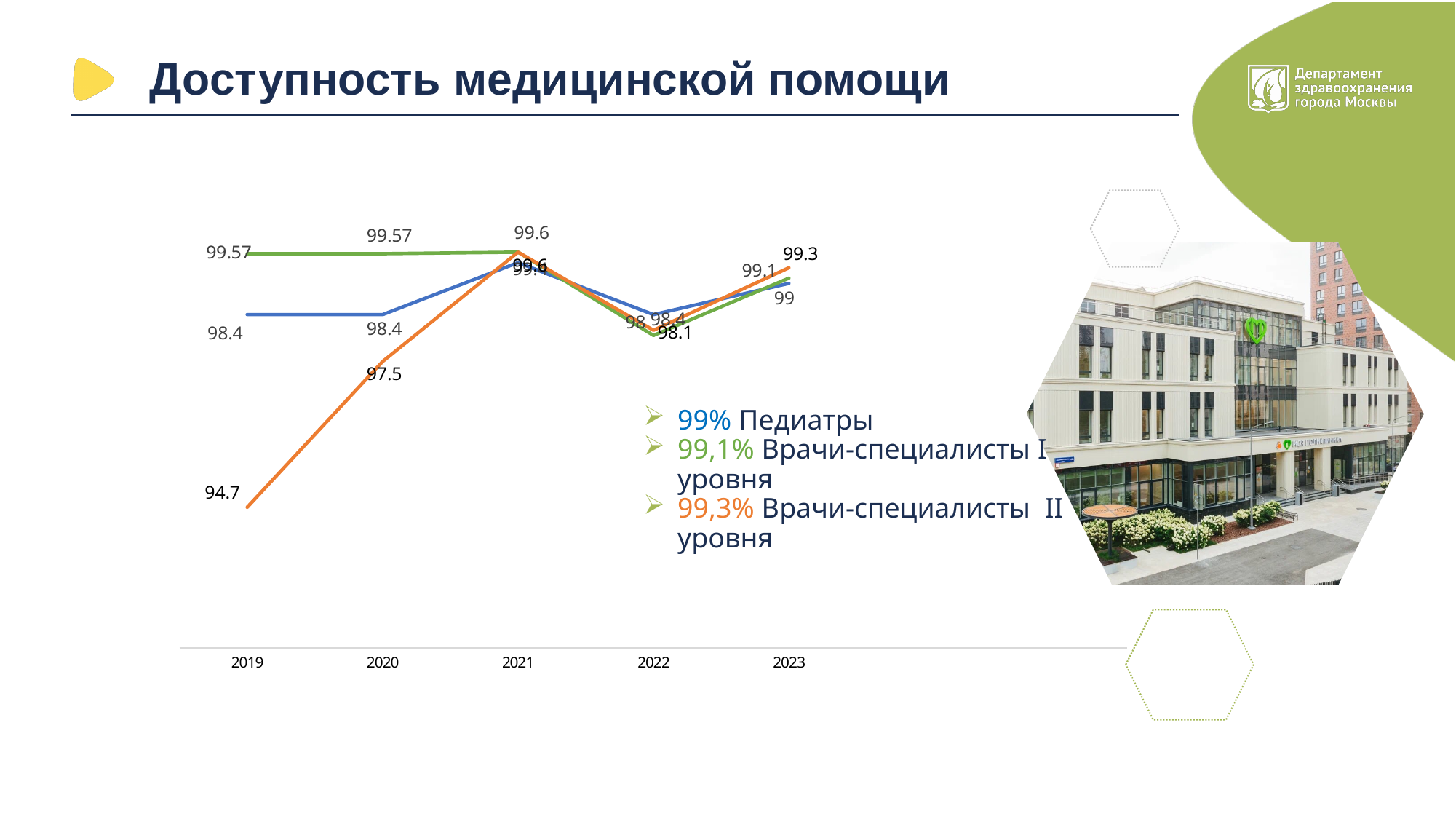
What is the value of the blue line in 2019? 98.4 What is the value of the orange line in 2023? 99.3 What is the value of the green line in 2019? 99.57 What kind of chart is shown on the slide? line chart What is the value of the orange line in 2020? 97.5 What is the value of the orange line in 2019? 94.7 Which year has the lowest value on the orange line? 2019 By how much did the orange line increase from 2019 to 2020? 2.8 How many years are shown on the x axis of the chart? 5 How many lines are plotted on the chart? 3 Does the orange line rise or fall from 2019 to 2021? rise In 2019, which is larger: the green line or the orange line? the green line